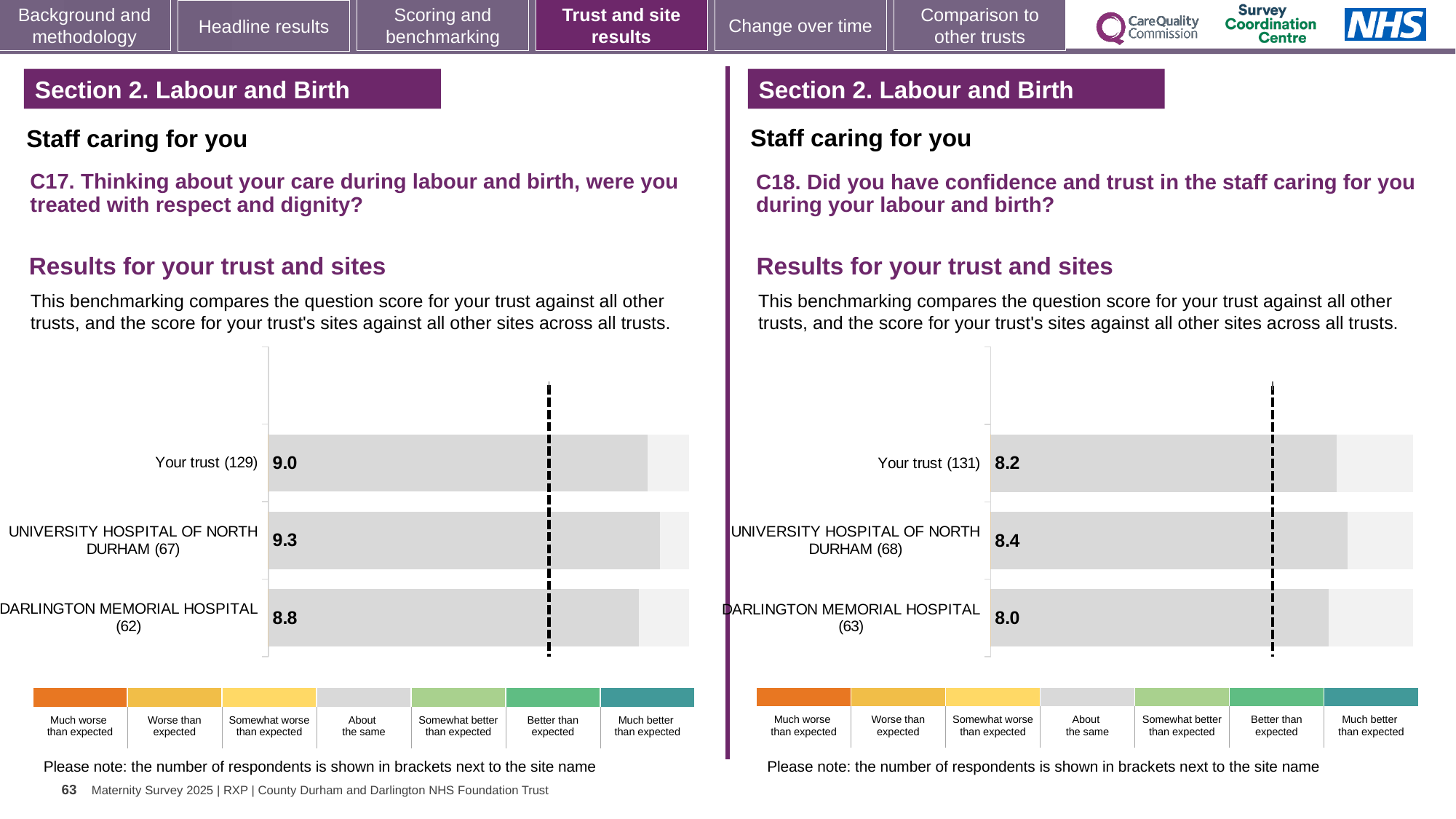
How many bars are plotted in the C17 chart on the left? 3 In the C18 chart on the right, which has the larger score, Your trust or Darlington Memorial Hospital? Your trust In the C17 chart on the left, which site or trust has the highest score? University Hospital of North Durham In the C18 chart on the right, what is the difference between the scores for University Hospital of North Durham and Your trust? 0.2 In the C17 chart on the left, what is the difference between the scores for University Hospital of North Durham and Darlington Memorial Hospital? 0.5 What type of chart is used in the C18 chart on the right? Bar chart In the C17 chart on the left, what is the score for Darlington Memorial Hospital? 8.8 In the C18 chart on the right, what is the score for University Hospital of North Durham? 8.4 In the C17 chart on the left, what is the score for University Hospital of North Durham? 9.3 In the C17 chart on the left, what is the score for Your trust? 9.0 In the C18 chart on the right, which site or trust has the lowest score? Darlington Memorial Hospital In the C18 chart on the right, what is the score for Your trust? 8.2